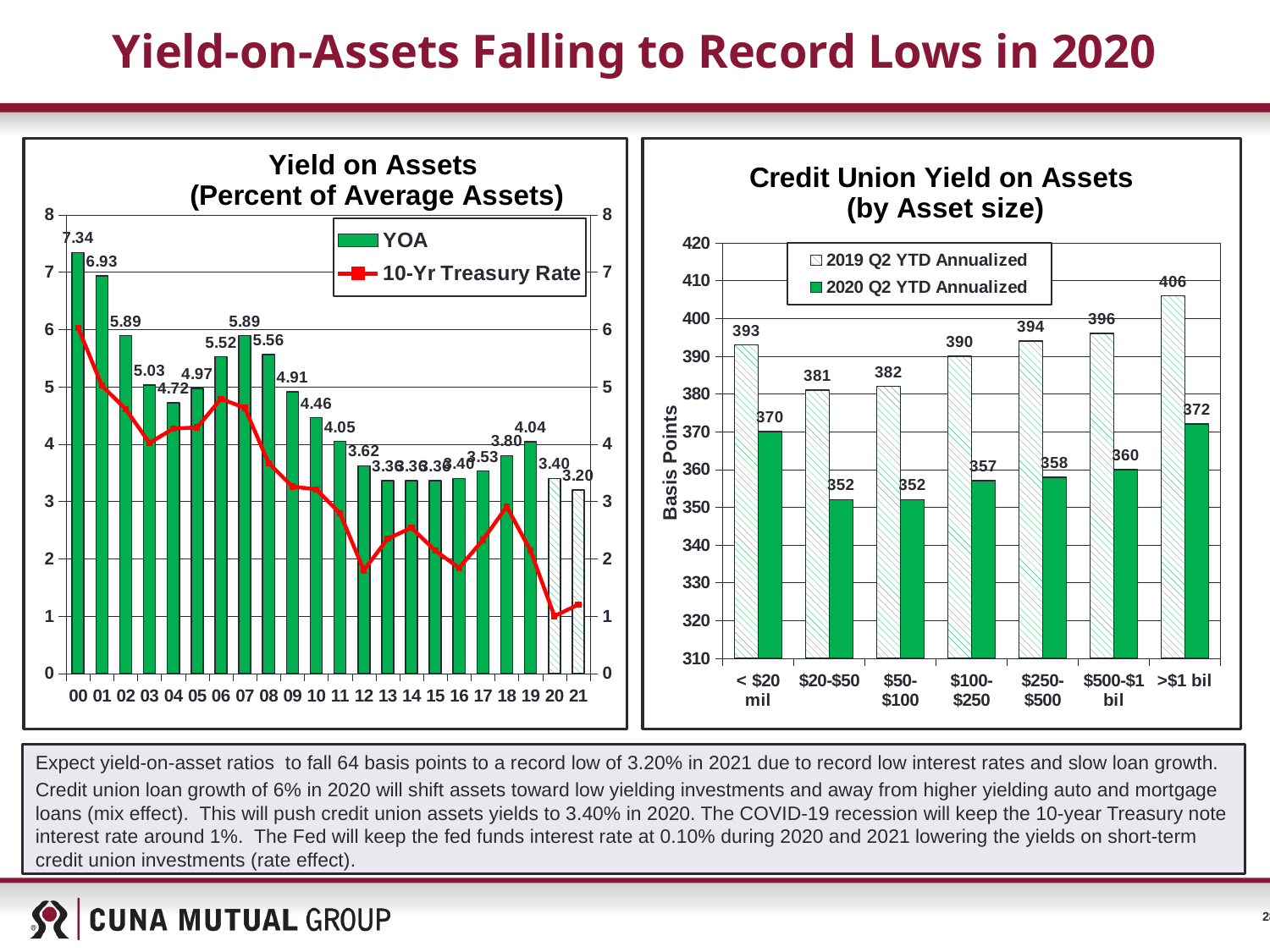
In the Yield on Assets chart, is the 10-Yr Treasury Rate for 00 greater or less than 5? greater In the Yield on Assets chart, what is the YOA value for 2000 (labelled 00)? 7.34 In the Credit Union Yield on Assets (by Asset size) chart, what is the 2020 Q2 YTD Annualized value for >$1 bil? 372 In the Credit Union Yield on Assets (by Asset size) chart, which asset size has the highest 2019 Q2 YTD Annualized value? >$1 bil In the Credit Union Yield on Assets (by Asset size) chart, what is the difference between the 2019 and 2020 Q2 YTD Annualized values for < $20 mil? 23 In the Credit Union Yield on Assets (by Asset size) chart, how many asset size categories are shown? 7 In the Credit Union Yield on Assets (by Asset size) chart, what is the 2019 Q2 YTD Annualized value for $100-$250? 390 In the Yield on Assets chart, what is the YOA value for 2021 (labelled 21)? 3.20 In the Yield on Assets chart, which is larger, the YOA value for 07 or for 08? 07 In the Yield on Assets chart, how many series does the legend list? 2 In the Yield on Assets chart, which year has the highest YOA bar? 00 In the Yield on Assets chart, what is the difference between the YOA values for 19 and 20? 0.64